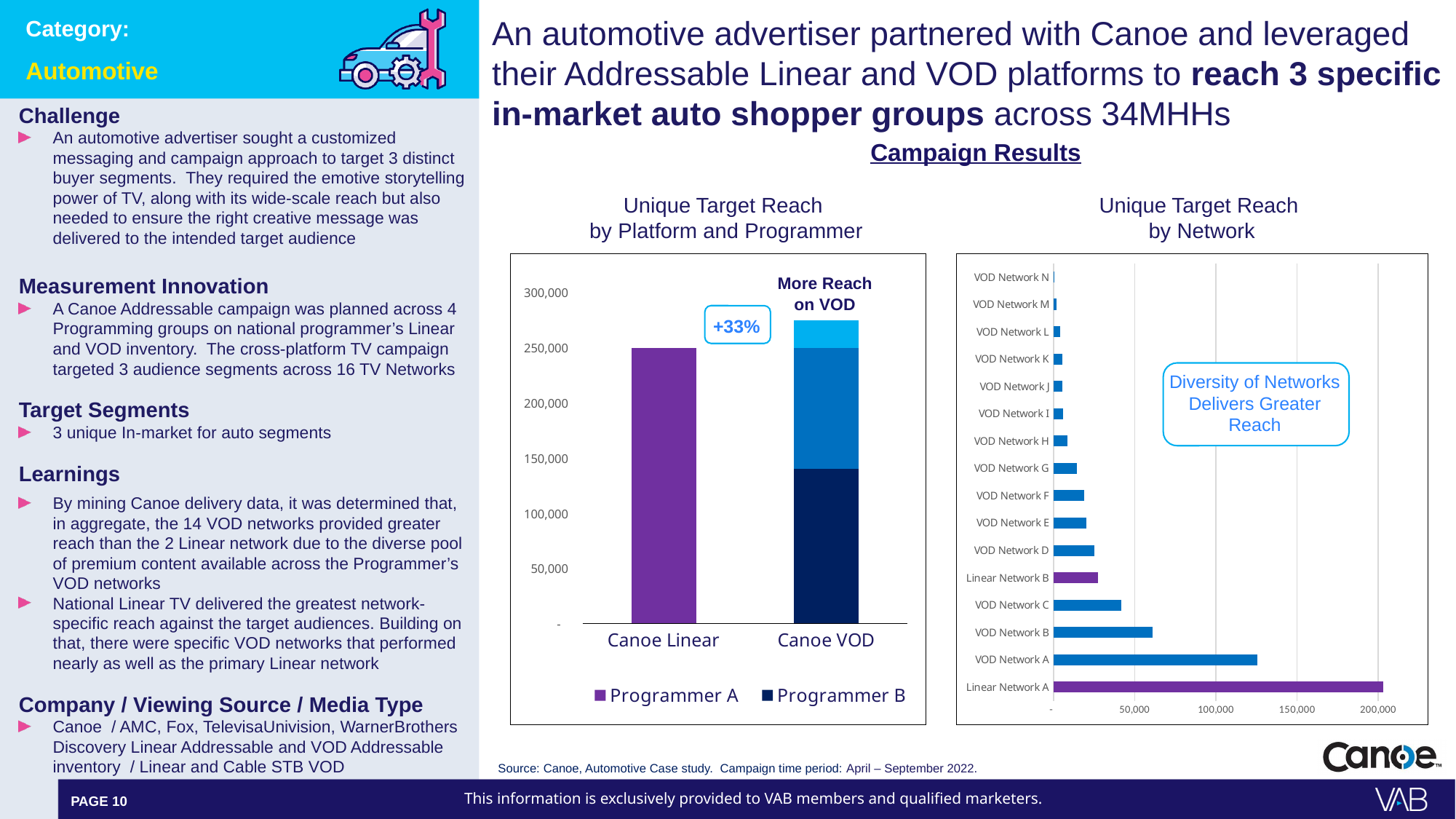
In the 'Unique Target Reach by Network' chart, is the value for VOD Network A greater or less than 100,000? greater In the 'Unique Target Reach by Network' chart, how many networks are listed? 16 In the 'Unique Target Reach by Platform and Programmer' chart, how many series does the legend list? 2 In the 'Unique Target Reach by Platform and Programmer' chart, how many platform categories are shown on the x axis? 2 In the 'Unique Target Reach by Platform and Programmer' chart, which bar is taller overall, Canoe Linear or Canoe VOD? Canoe VOD In the 'Unique Target Reach by Platform and Programmer' chart, is the value for Canoe Linear greater or less than 200,000? greater What kind of chart is the 'Unique Target Reach by Platform and Programmer' chart? bar chart What kind of chart is the 'Unique Target Reach by Network' chart? bar chart In the 'Unique Target Reach by Platform and Programmer' chart, what percentage increase is shown in the callout between the two bars? +33% In the 'Unique Target Reach by Network' chart, which network has the lowest reach? VOD Network N In the 'Unique Target Reach by Network' chart, which has the larger reach, VOD Network C or Linear Network B? VOD Network C In the 'Unique Target Reach by Network' chart, which network has the highest reach? Linear Network A